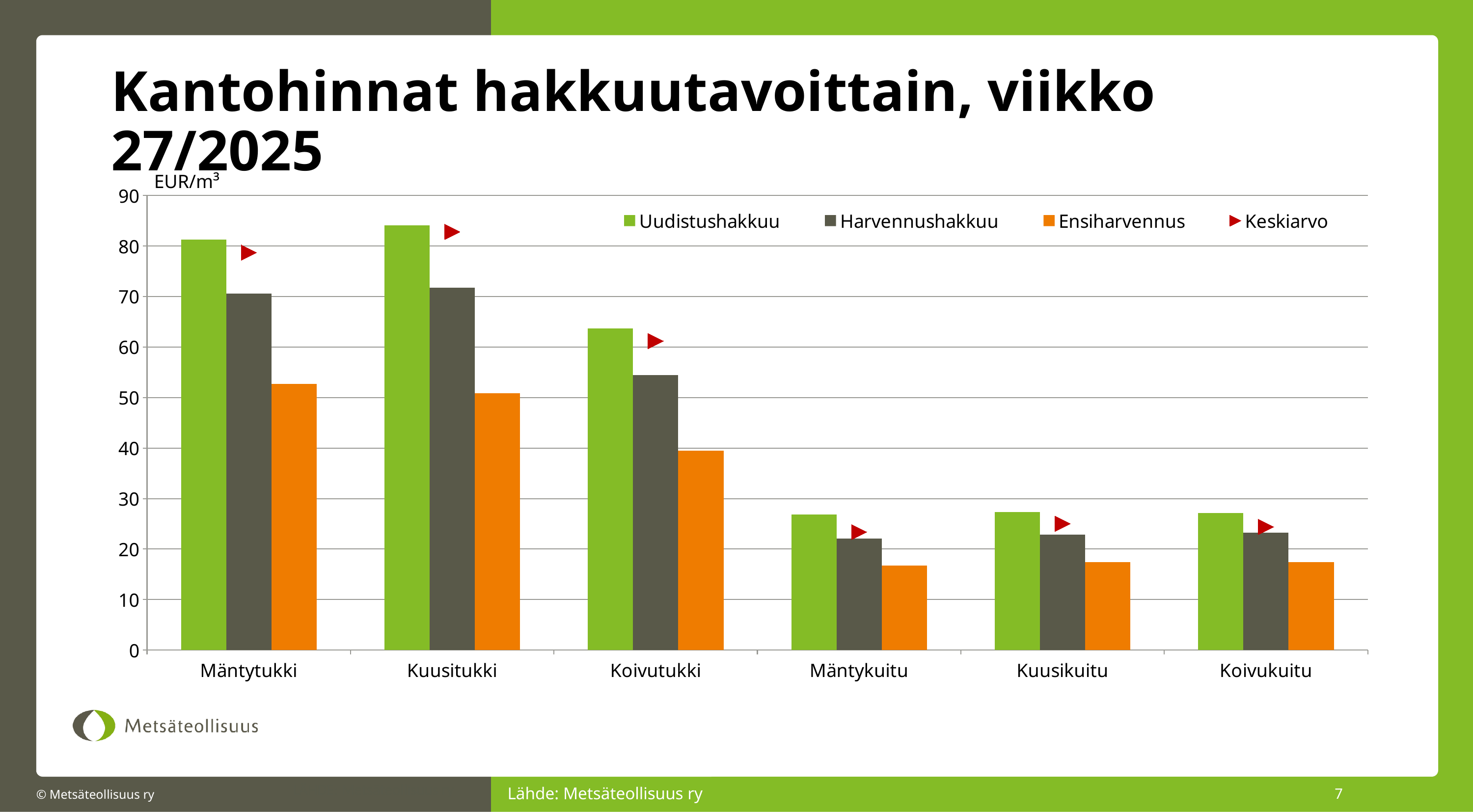
What kind of chart is shown on the slide? bar chart Which is larger: the Ensiharvennus value for Kuusitukki or the Harvennushakkuu value for Koivutukki? Harvennushakkuu value for Koivutukki How many categories are shown on the x axis of the chart? 6 Which is larger: the Uudistushakkuu value for Mäntytukki or the Uudistushakkuu value for Koivutukki? Mäntytukki Which series has the highest value within the Koivutukki category? Uudistushakkuu Is the Harvennushakkuu value for Kuusitukki greater or less than 70? greater Is the Ensiharvennus value for Mäntykuitu greater or less than 20? less How many series does the chart's legend list? 4 Which category has the highest Uudistushakkuu value? Kuusitukki What unit is shown above the y axis of the chart? EUR/m³ Is the Uudistushakkuu value for Mäntytukki greater or less than 80? greater